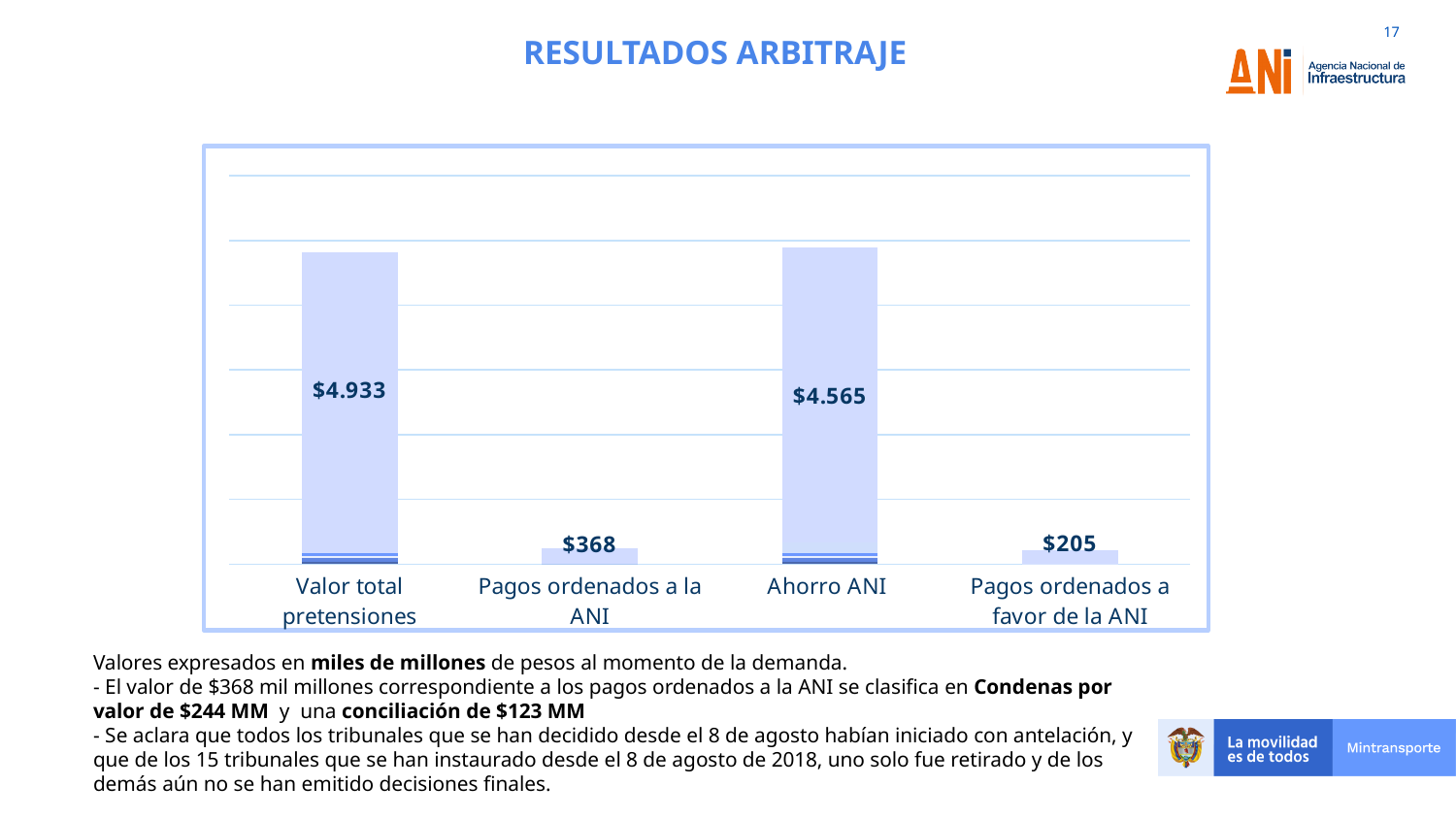
Which category has the lowest value? Pagos ordenados a favor de la ANI What is the difference between Pagos ordenados a la ANI and Pagos ordenados a favor de la ANI? $163 What is the value for Ahorro ANI? $4.565 Which is larger, Ahorro ANI or Valor total pretensiones? Valor total pretensiones Which is larger, Pagos ordenados a la ANI or Pagos ordenados a favor de la ANI? Pagos ordenados a la ANI How many categories are shown in the chart? 4 What is the value for Pagos ordenados a favor de la ANI? $205 What is the value for Valor total pretensiones? $4.933 What is the value for Pagos ordenados a la ANI? $368 What kind of chart is shown on the slide? Bar chart What is the difference between Valor total pretensiones and Ahorro ANI? $368 Which category has the highest value? Valor total pretensiones